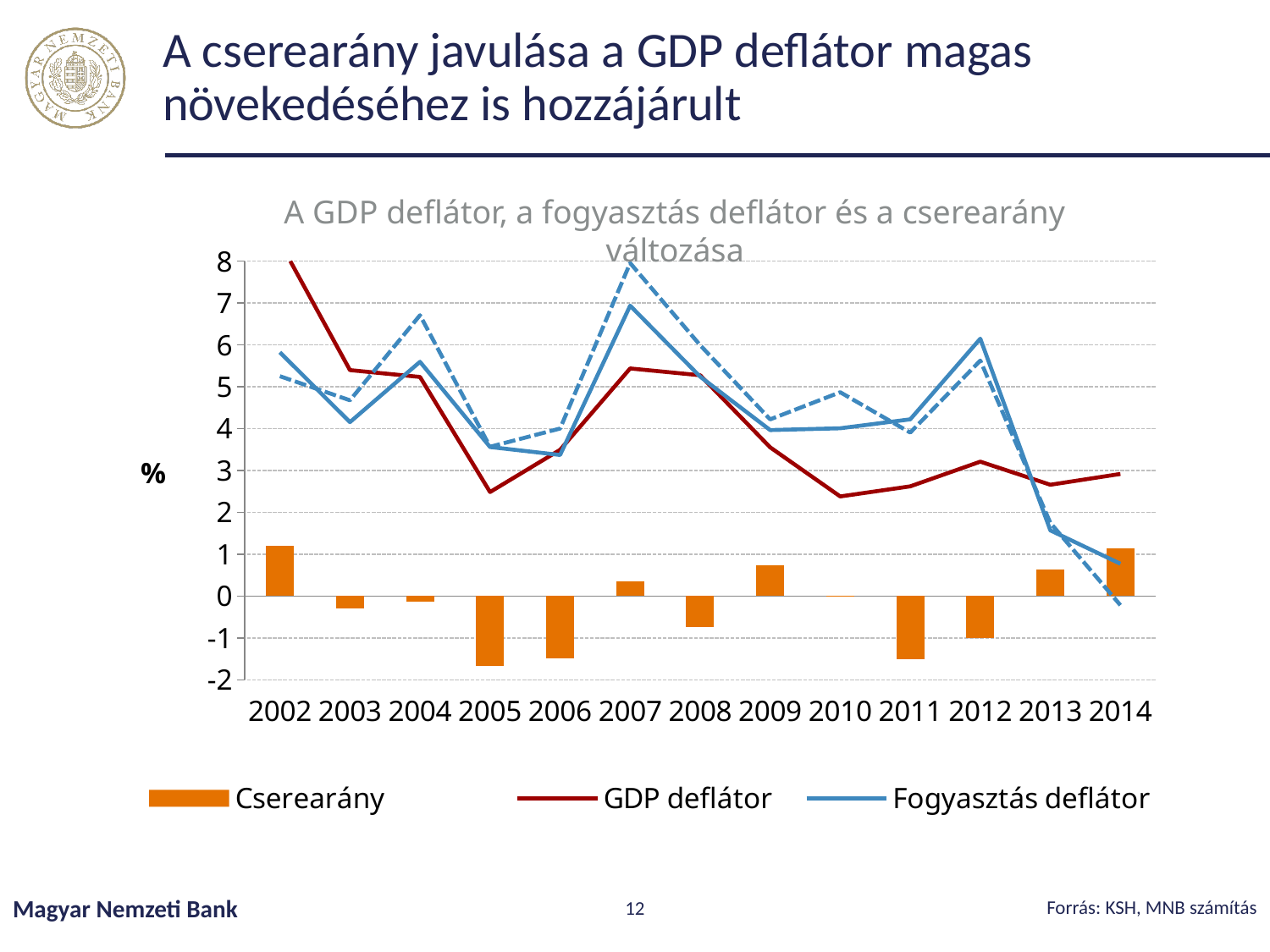
In which year is the GDP deflátor line at its highest? 2002 How many series does the legend list? 3 What kind of chart is shown on the slide? A combined bar and line chart In which year is the GDP deflátor line at its lowest? 2010 Does the GDP deflátor line rise or fall from 2002 to 2005? fall Is the GDP deflátor value for 2010 greater or less than 3? less How many years are shown on the x axis? 13 In 2007, which is larger: the GDP deflátor or the Fogyasztás deflátor? Fogyasztás deflátor Which series is shown as orange bars? Cserearány Is the Cserearány value for 2005 greater or less than -1? less Is the GDP deflátor value for 2002 greater or less than 7? greater In which year does the solid Fogyasztás deflátor line reach its highest value? 2007